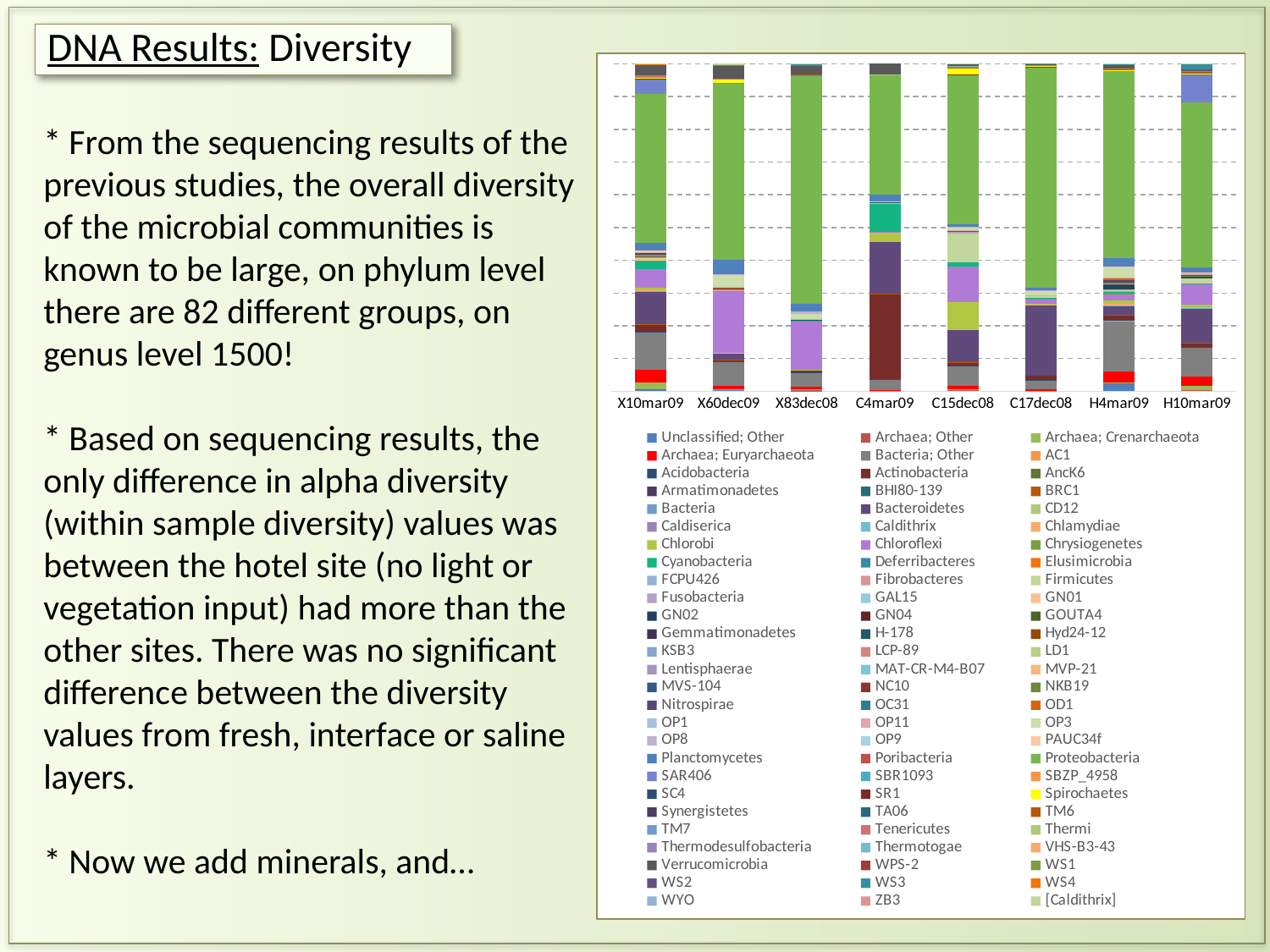
Which sample is the first (leftmost) category on the x axis? X10mar09 Which sample has the larger red (Archaea; Euryarchaeota) segment at the bottom of its bar, X10mar09 or X83dec08? X10mar09 Which sample bar has the largest green (Proteobacteria) segment? X83dec08 Which sample bar has the largest dark red (Actinobacteria) segment? C4mar09 Which sample bar has the smallest green (Proteobacteria) segment? C4mar09 Which sample is the last (rightmost) category on the x axis? H10mar09 Which sample has the smaller green (Proteobacteria) segment, X83dec08 or C4mar09? C4mar09 Which sample bar has the largest light purple (Chloroflexi) segment? X60dec09 What kind of chart is shown on the slide? Stacked bar chart How many sample bars are shown along the x axis of the chart? 8